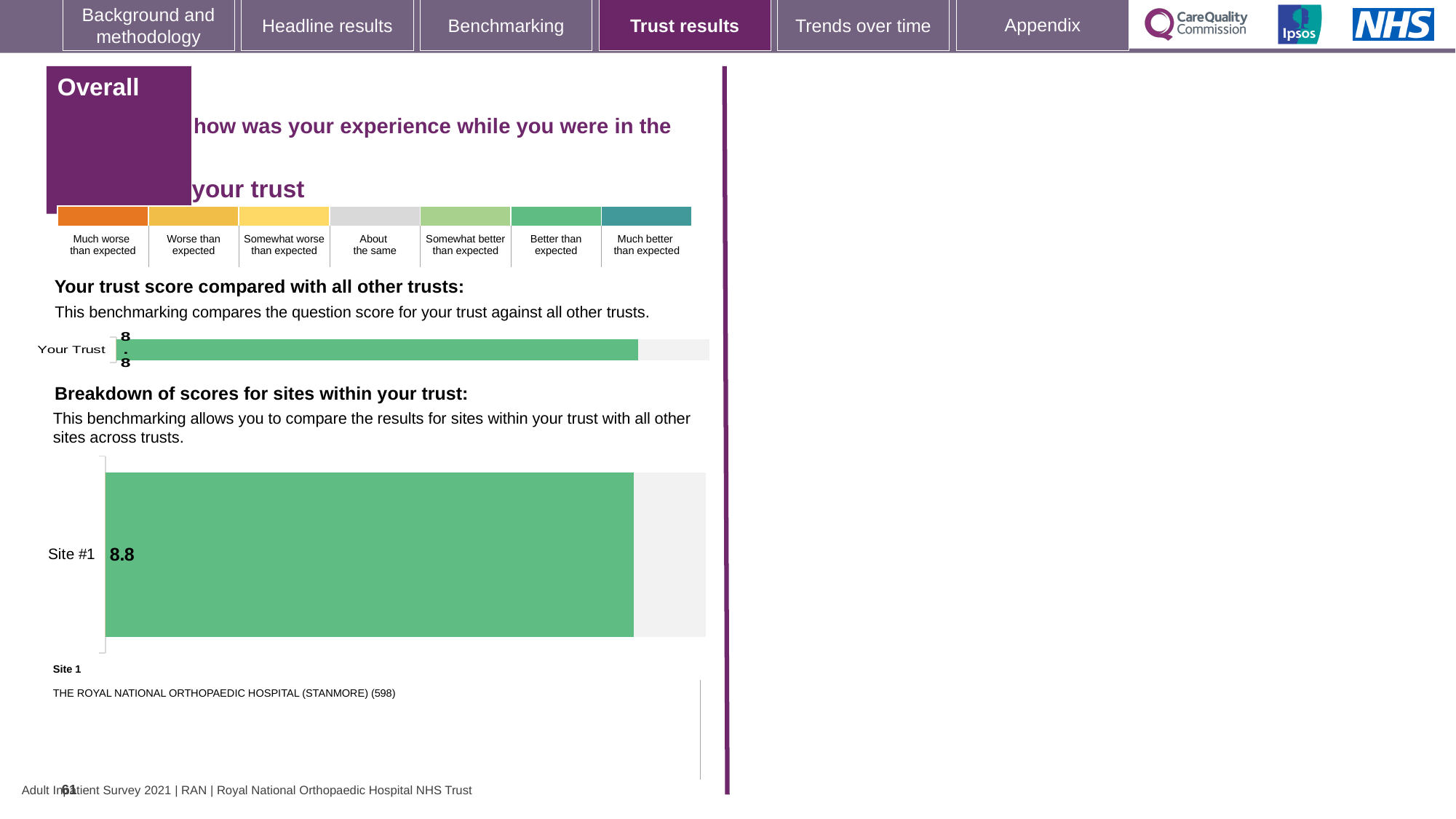
What kind of chart is the 'Breakdown of scores for sites within your trust' chart? Bar chart According to the colour key on the slide, which rating category does the green colour of the Site #1 bar correspond to? Better than expected What is the difference between the Your Trust score in the top chart and the Site #1 score in the bottom chart? 0.0 How many bars are plotted in the 'Your trust score compared with all other trusts' chart? 1 What kind of chart is the 'Your trust score compared with all other trusts' chart? Bar chart In the 'Breakdown of scores for sites within your trust' chart, what colour is the bar for Site #1? Green In the 'Breakdown of scores for sites within your trust' chart, what is the value for Site #1? 8.8 Which hospital is listed as Site 1 below the 'Breakdown of scores for sites within your trust' chart? THE ROYAL NATIONAL ORTHOPAEDIC HOSPITAL (STANMORE) (598) In the 'Your trust score compared with all other trusts' chart, what is the value for Your Trust? 8.8 Is the Your Trust score in the top chart larger than, smaller than, or equal to the Site #1 score in the bottom chart? Equal How many sites are plotted in the 'Breakdown of scores for sites within your trust' chart? 1